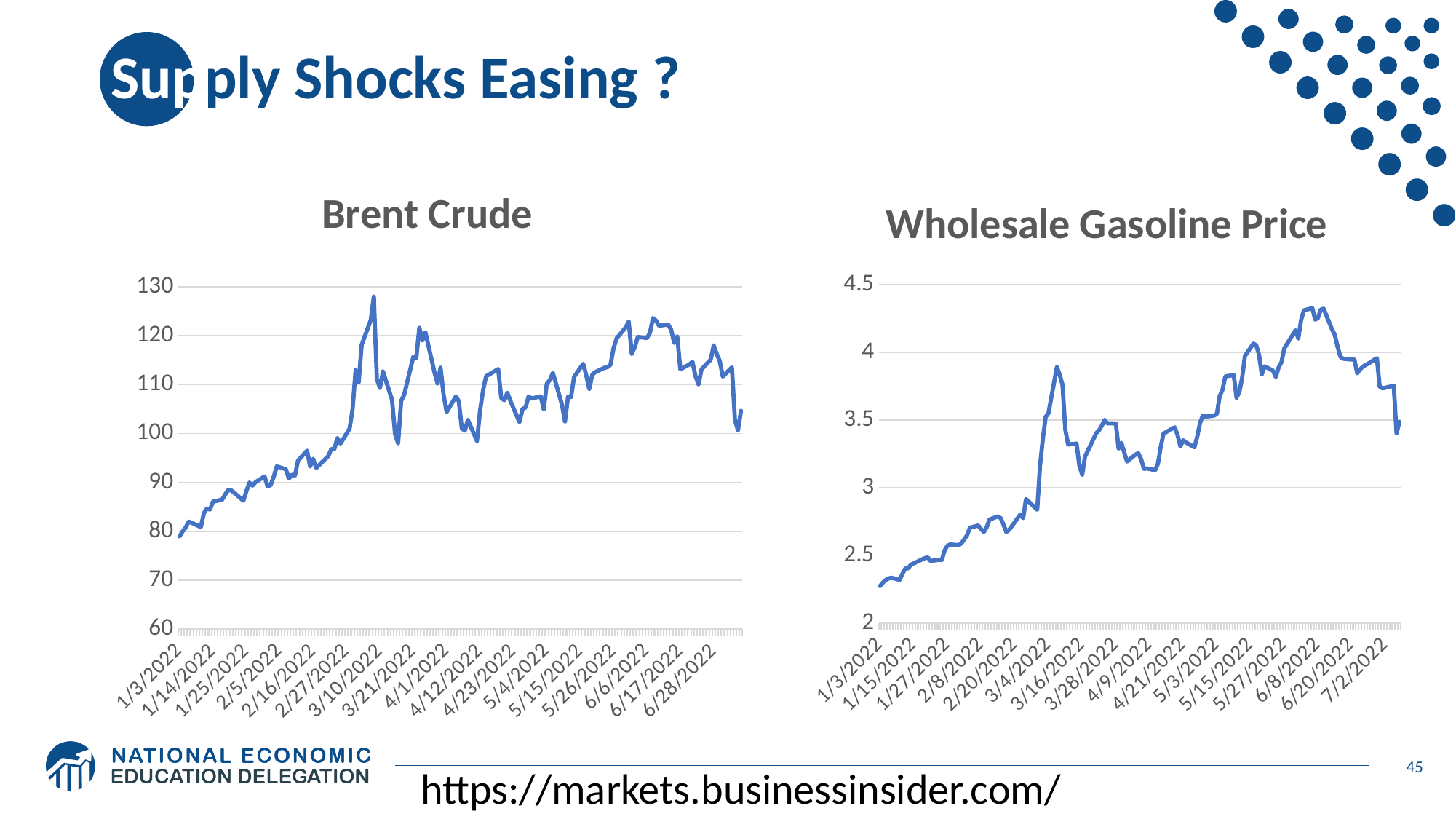
What kind of chart is the Wholesale Gasoline Price chart? line chart In the Brent Crude chart, is the peak value reached around 3/10/2022 greater or less than 120? greater In the Brent Crude chart, does the value rise or fall between 1/3/2022 and 2/27/2022? rise In the Wholesale Gasoline Price chart, does the value rise or fall between 1/3/2022 and 3/4/2022? rise In the Brent Crude chart, is the value on 1/3/2022 greater or less than 90? less In the Wholesale Gasoline Price chart, is the value on 1/3/2022 greater or less than 2.5? less What kind of chart is the Brent Crude chart? line chart In the Brent Crude chart, does the value rise or fall over the last few points at the end of June 2022? fall What is the title of the chart on the right side of the slide? Wholesale Gasoline Price What is the lowest value shown on the y axis of the Brent Crude chart? 60